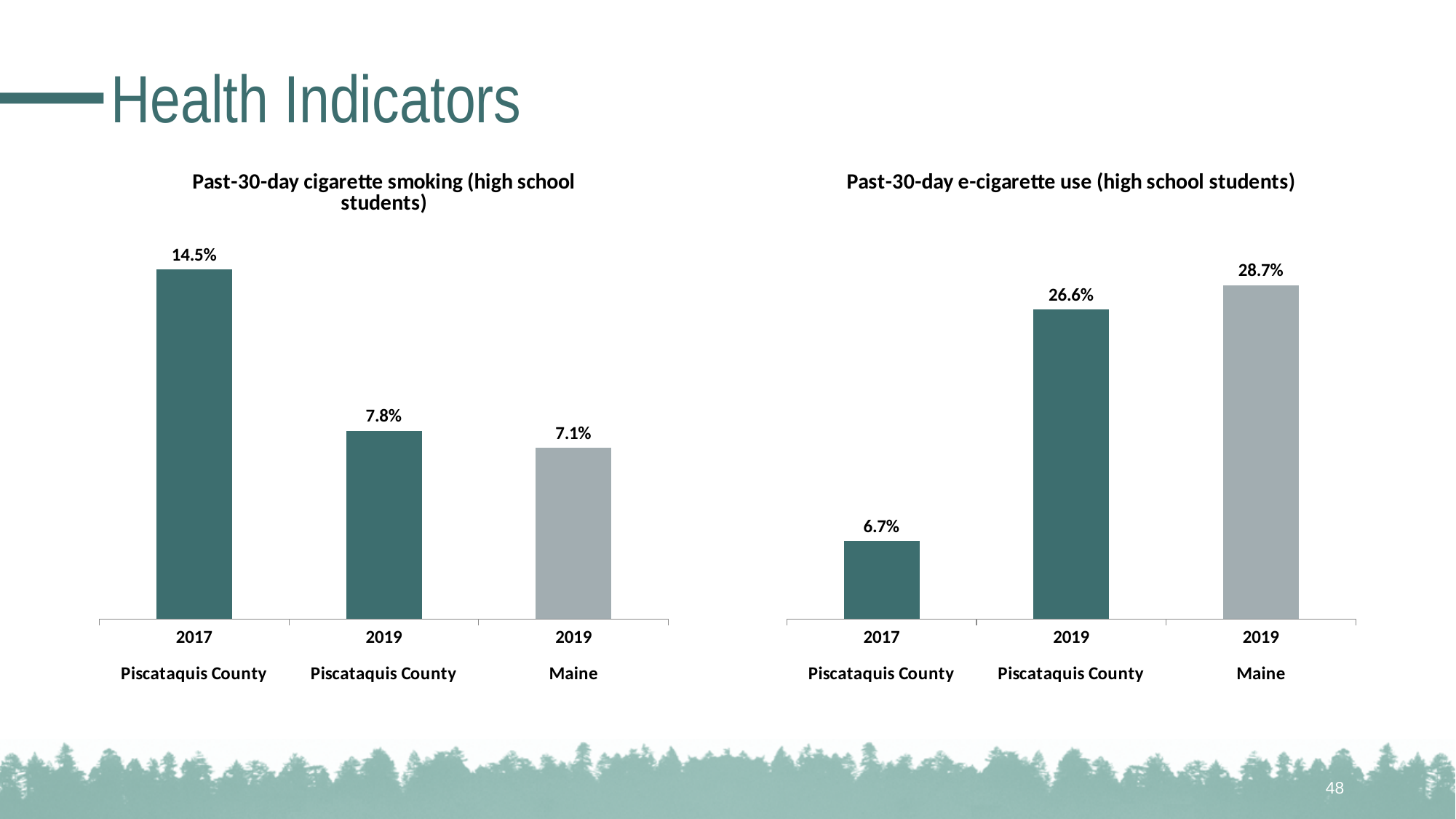
How many bars are in the 'Past-30-day cigarette smoking (high school students)' chart? 3 In the 'Past-30-day cigarette smoking (high school students)' chart, which bar is the highest? Piscataquis County 2017 What type of chart is the 'Past-30-day e-cigarette use (high school students)' chart? Bar chart In the 'Past-30-day e-cigarette use (high school students)' chart, what is the difference between the Maine 2019 and Piscataquis County 2019 values? 2.1% In the 'Past-30-day e-cigarette use (high school students)' chart, what is the value for Piscataquis County in 2019? 26.6% In the 'Past-30-day cigarette smoking (high school students)' chart, what is the value for Piscataquis County in 2017? 14.5% In the 'Past-30-day e-cigarette use (high school students)' chart, which bar is the lowest? Piscataquis County 2017 In the 'Past-30-day cigarette smoking (high school students)' chart, what is the difference between the Piscataquis County 2017 and 2019 values? 6.7% In the 'Past-30-day e-cigarette use (high school students)' chart, which is larger in 2019: Piscataquis County or Maine? Maine In the 'Past-30-day cigarette smoking (high school students)' chart, did the Piscataquis County value rise or fall from 2017 to 2019? Fall In the 'Past-30-day e-cigarette use (high school students)' chart, what is the value for Piscataquis County in 2017? 6.7% In the 'Past-30-day cigarette smoking (high school students)' chart, what is the value for Maine in 2019? 7.1%